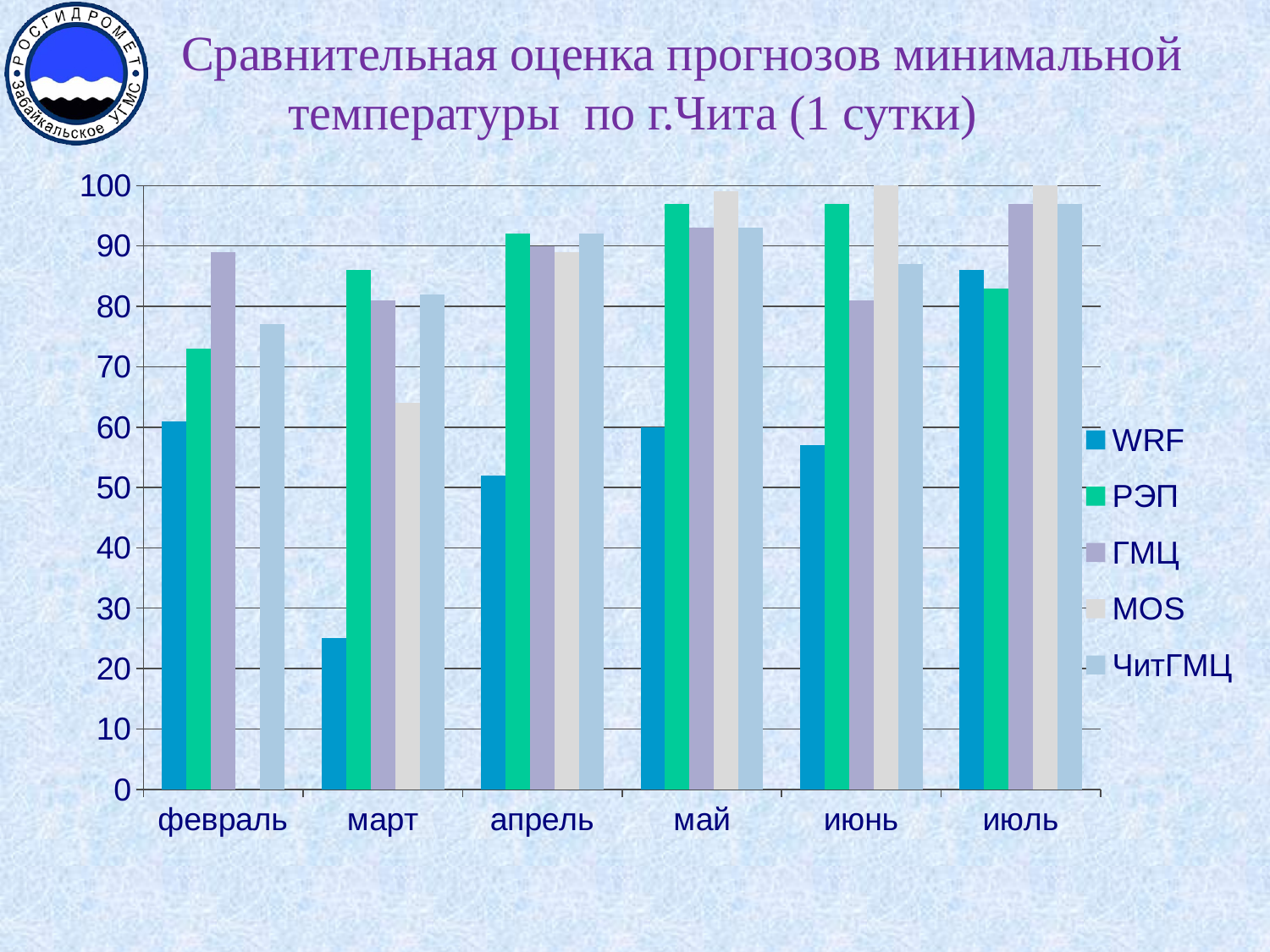
Is the value for ЧитГМЦ in февраль greater or less than 70? greater In which month is the WRF value highest? июль Is the value for ГМЦ in июнь greater or less than 90? less How many series does the legend list? 5 In март, which is larger: the value for WRF or for MOS? MOS How many months are shown on the x axis? 6 In which month is the WRF value lowest? март Is the value for WRF in март greater or less than 30? less What kind of chart is shown on the slide? bar chart In февраль, which is larger: the value for ГМЦ or for РЭП? ГМЦ Which series is listed first in the legend? WRF